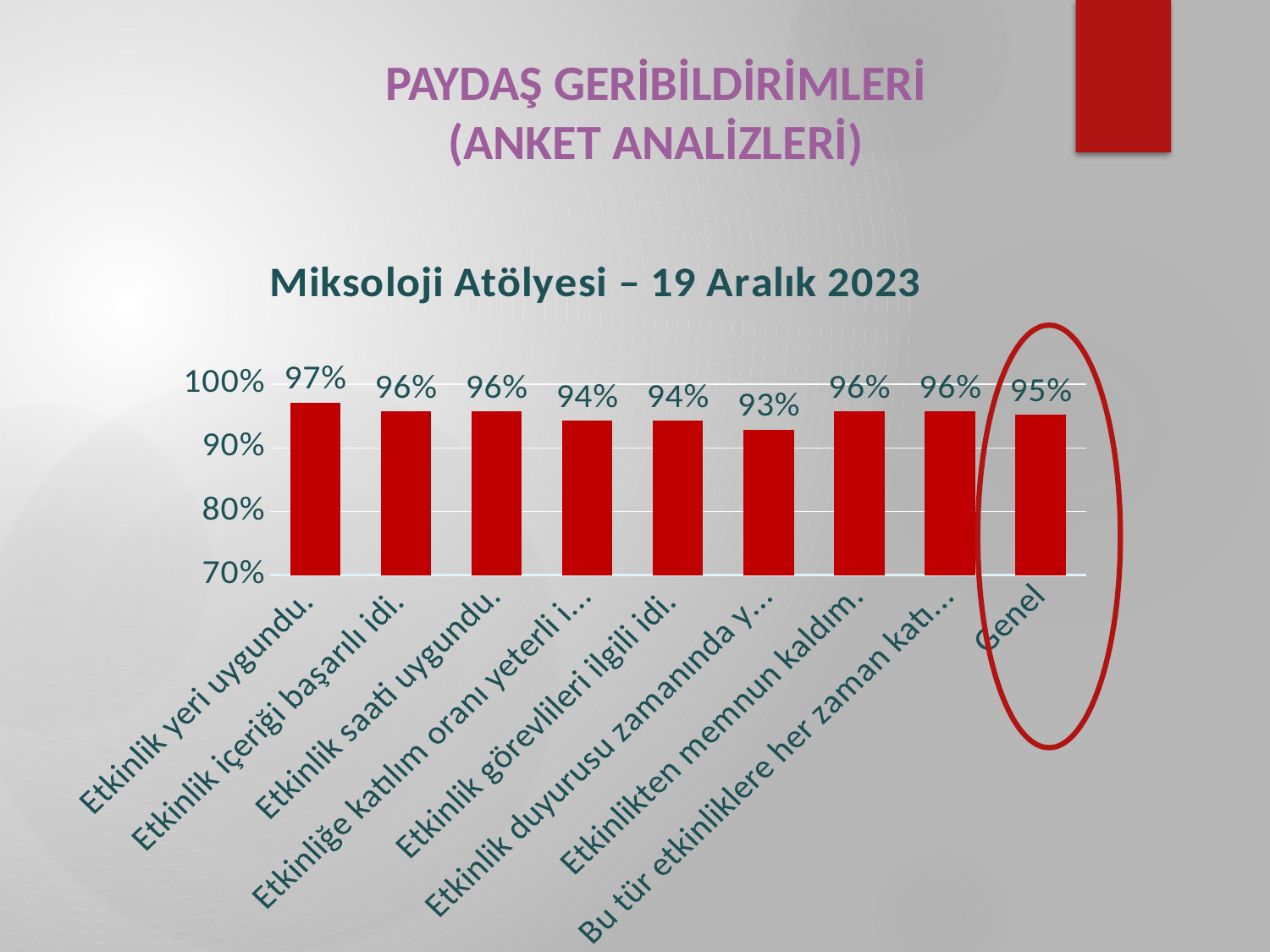
How many bars are shown in the chart? 9 What is the lowest value shown in the chart? 93% Is the value for "Genel" greater or less than 90%? greater What is the value for "Genel"? 95% What is the value for "Etkinlik görevlileri ilgili idi."? 94% What kind of chart is shown on the slide? bar chart Which is larger, the value for "Etkinlik saati uygundu." or the value for "Etkinlik görevlileri ilgili idi."? Etkinlik saati uygundu. What is the value for "Etkinlikten memnun kaldım."? 96% What is the title of the chart? Miksoloji Atölyesi – 19 Aralık 2023 What is the difference between the values for "Etkinlik yeri uygundu." and "Genel"? 2% Which category has the highest value? Etkinlik yeri uygundu. What is the value for "Etkinlik yeri uygundu."? 97%